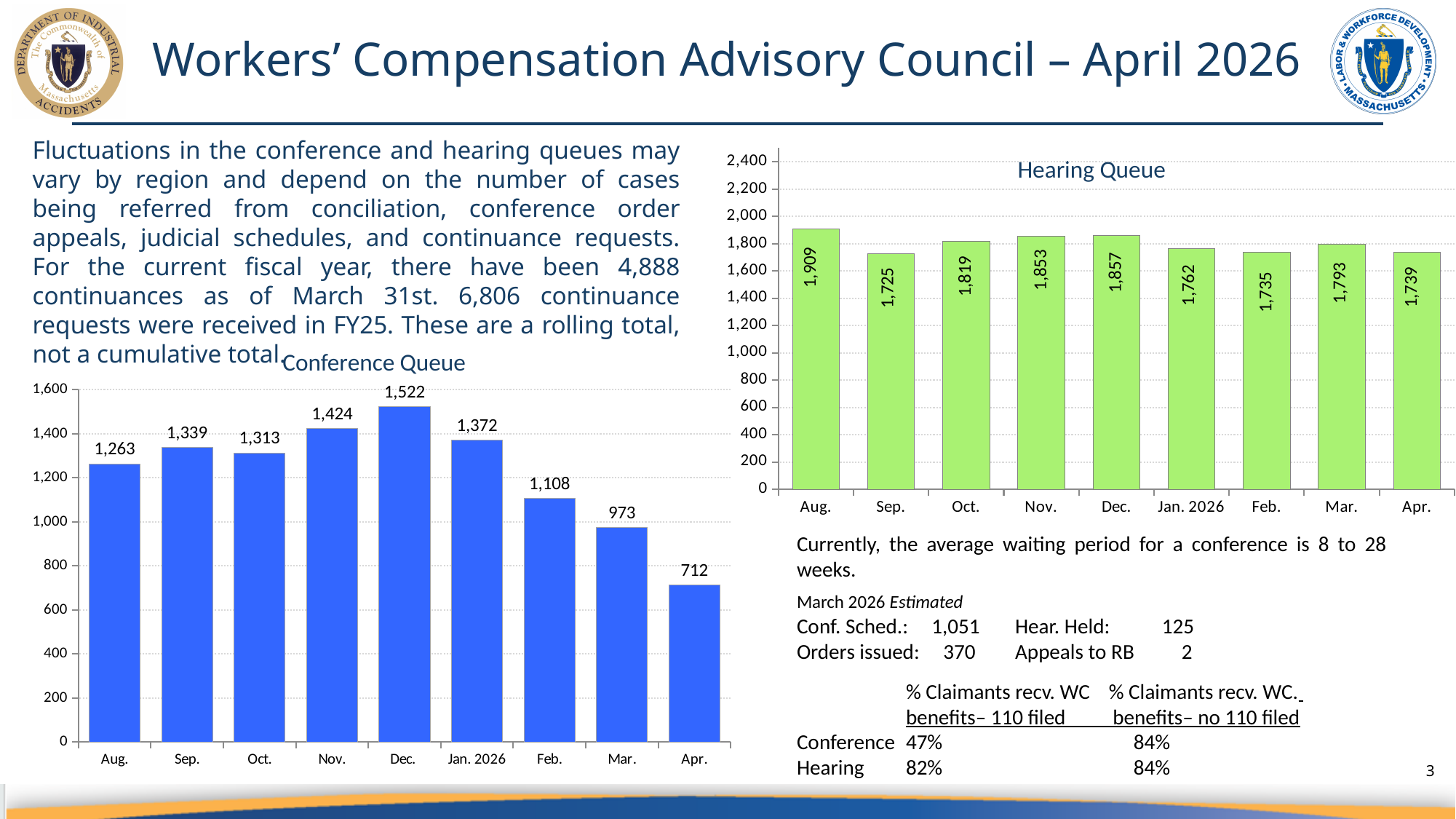
In the Conference Queue chart, which month has the lowest value? Apr. In the Hearing Queue chart, what is the value for Nov.? 1,853 How many months are shown in the Conference Queue chart? 9 In the Hearing Queue chart, which month has the lowest value? Sep. In the Conference Queue chart, which is larger, the value for Sep. or the value for Oct.? Sep. In the Conference Queue chart, what is the difference between the Dec. value and the Apr. value? 810 In the Hearing Queue chart, which month has the highest value? Aug. What colour are the bars in the Hearing Queue chart? Green In the Conference Queue chart, what is the value for Dec.? 1,522 What kind of chart is the Hearing Queue chart? Bar chart In the Hearing Queue chart, what is the difference between the Aug. value and the Sep. value? 184 In the Conference Queue chart, do the values rise or fall from Jan. 2026 to Apr.? Fall